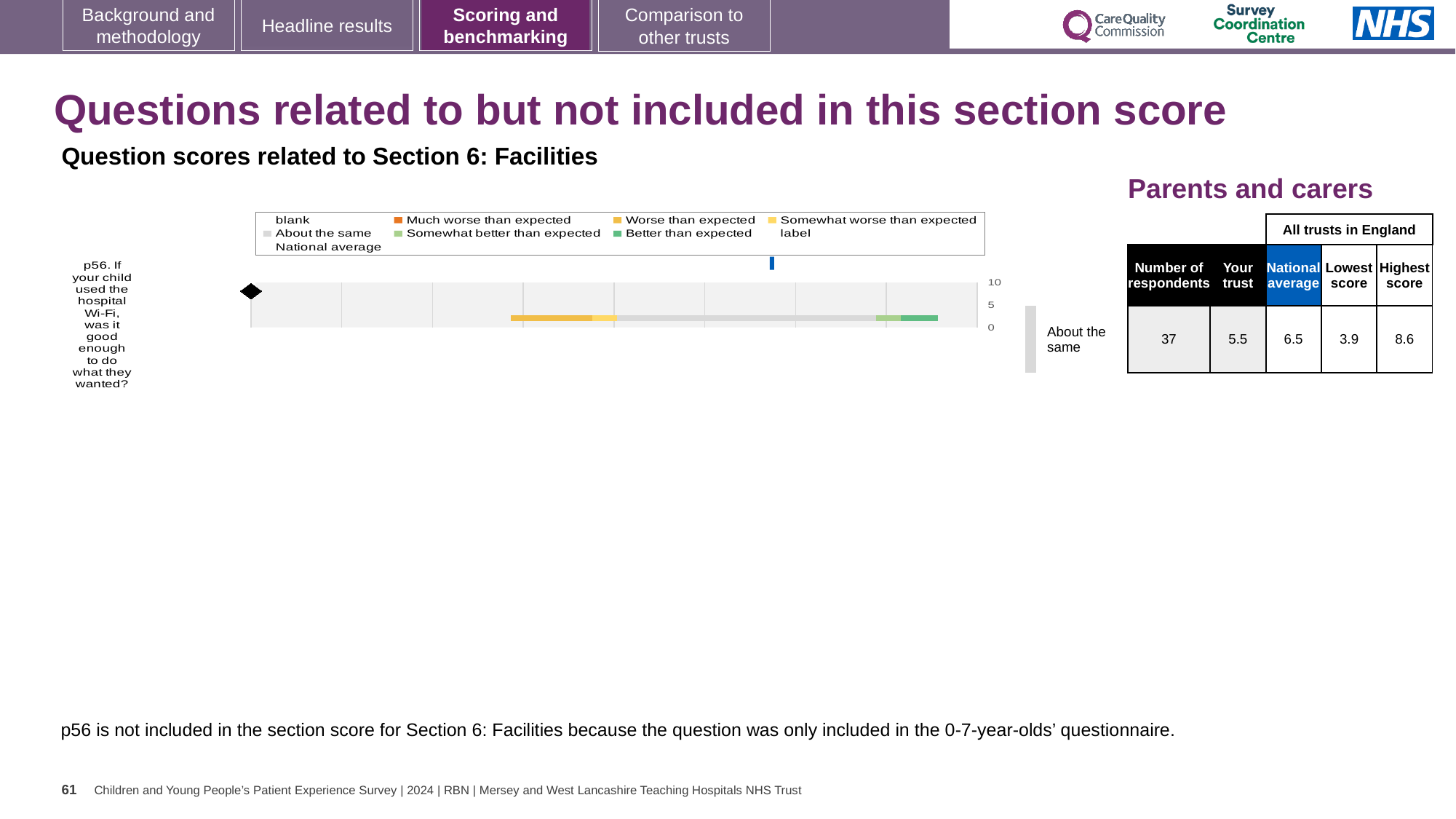
What is the difference between the National average and the Your trust score for p56? 1.0 Which question number is plotted in the chart? p56 How many respondents answered p56? 37 What is the Lowest score among all trusts in England for p56? 3.9 What is the difference between the Highest score and the Lowest score for p56? 4.7 Which is larger for p56, the Your trust score or the National average? National average What is the National average score for p56? 6.5 What benchmark category is p56 assigned to on the slide? About the same What kind of chart is shown on the slide? bar chart How many questions (categories) are plotted in the chart? 1 What is the Highest score among all trusts in England for p56? 8.6 What is the 'Your trust' score for p56 in the table? 5.5